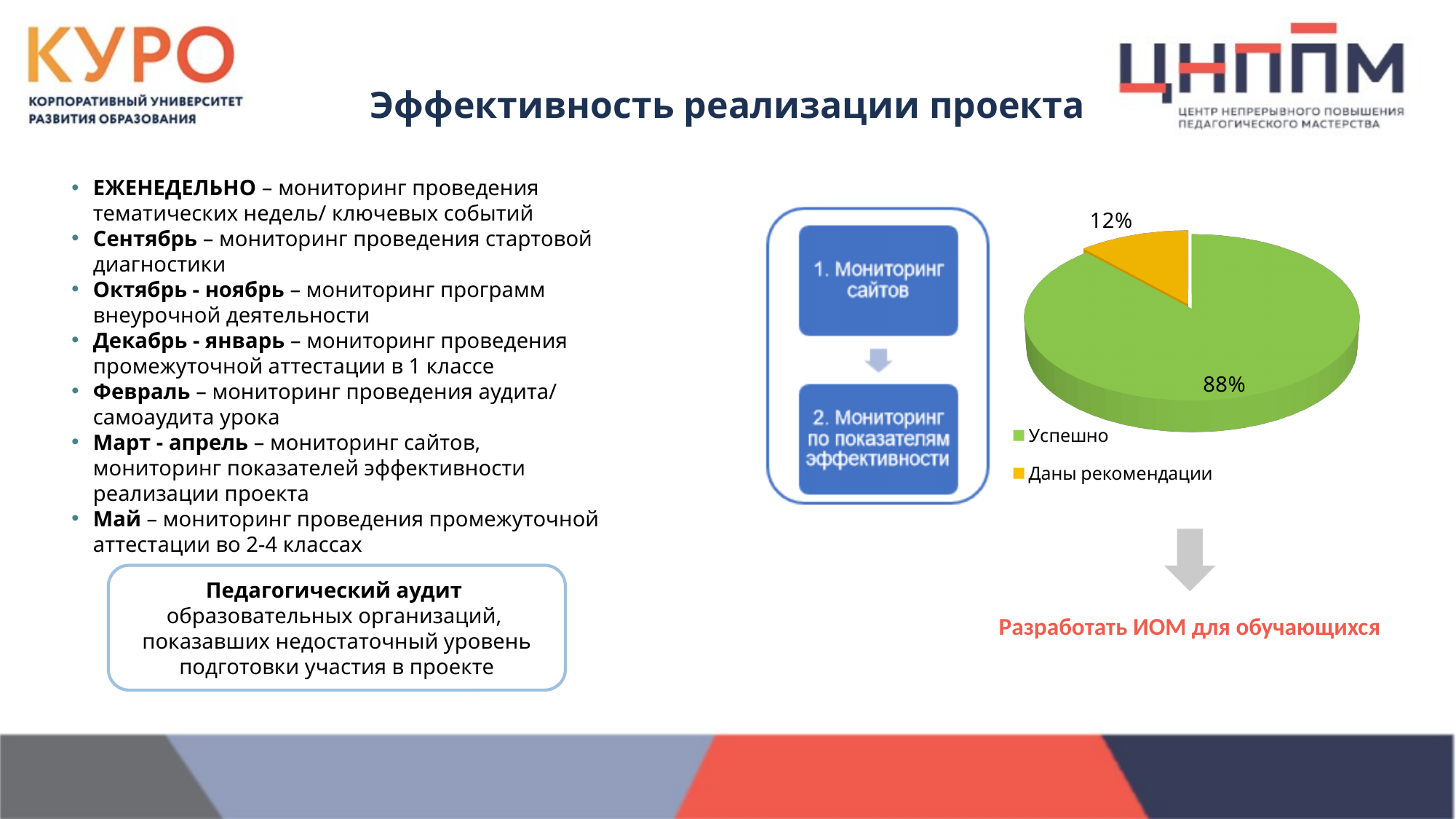
How many categories does the pie chart show? 2 What kind of chart is shown on the slide? pie chart Which is larger: the slice for "Успешно" or the slice for "Даны рекомендации"? Успешно What colour is the slice for "Даны рекомендации"? yellow What is the difference in percentage points between "Успешно" and "Даны рекомендации"? 76 How many entries does the legend list? 2 What share of the pie does "Даны рекомендации" represent? 12% What colour is the slice for "Успешно"? green What share of the pie does "Успешно" represent? 88% Which category has the largest slice of the pie? Успешно Which category has the smallest slice of the pie? Даны рекомендации